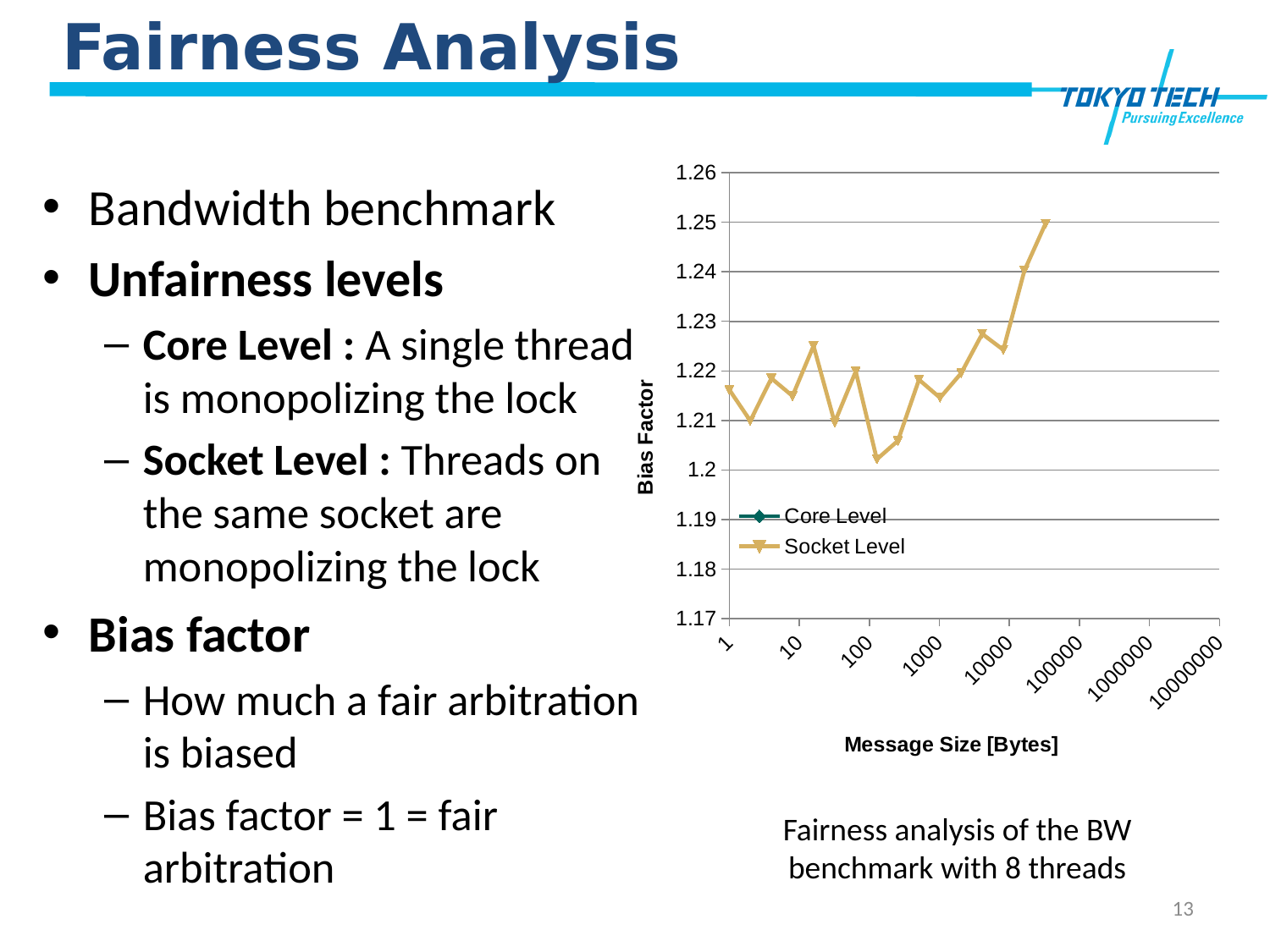
Is the Socket Level bias factor at a message size of 1 byte greater or less than 1.21? greater How many series does the chart legend list? 2 Is the Socket Level bias factor at a message size of 10000 bytes greater or less than 1.22? greater Does the Socket Level series reach its highest bias factor at the smallest or the largest message size plotted? largest Does the Socket Level bias factor ever drop below 1.2 on the chart? No What kind of chart is shown on the slide? Line chart What are the two series named in the chart legend? Core Level and Socket Level What is the title of the x axis of the chart? Message Size [Bytes] Does the Socket Level bias factor overall rise or fall as message size increases along the x axis? rise